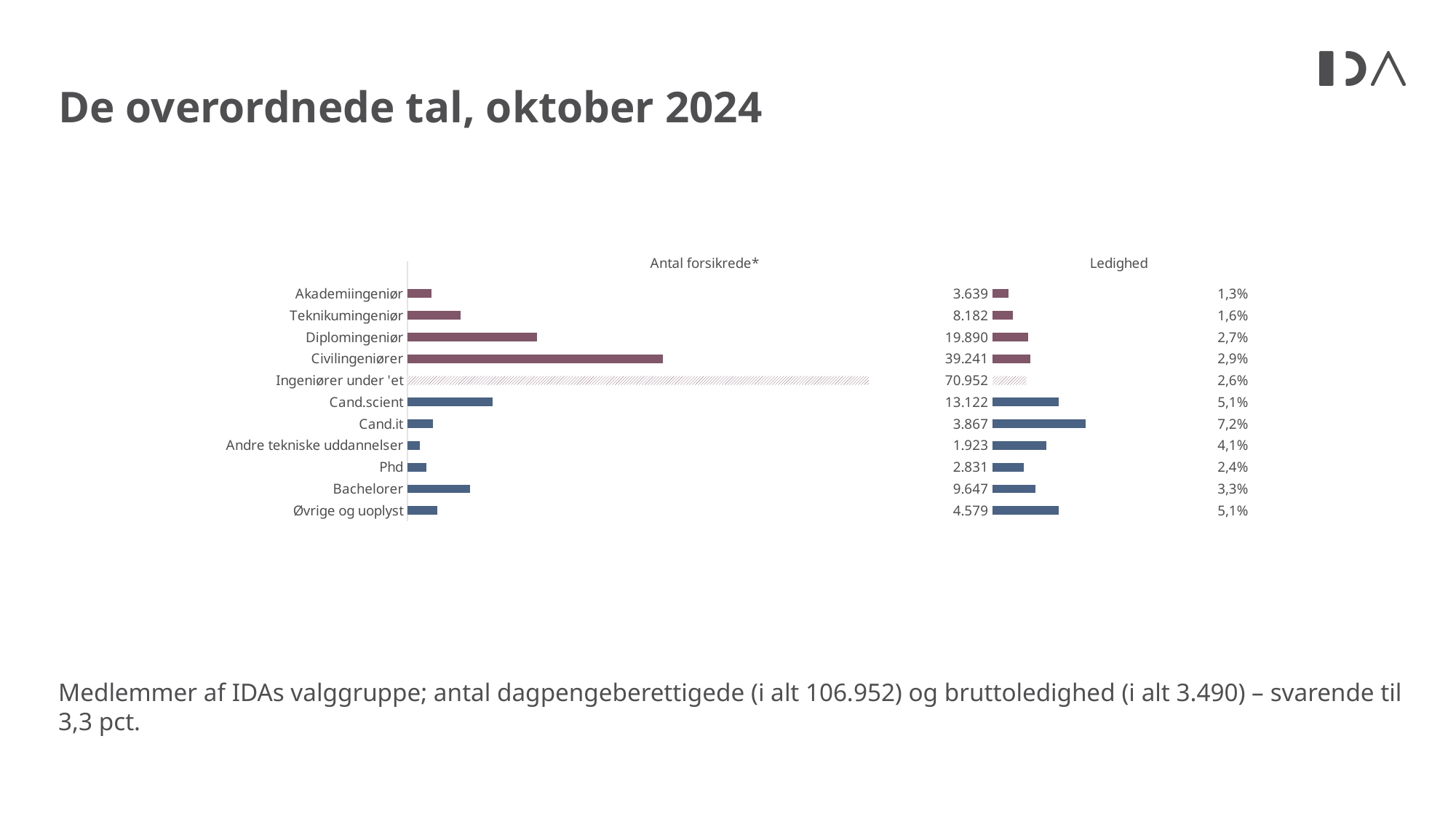
In the Ledighed chart, which category has the lowest value? Akademiingeniør In the Ledighed chart, what is the value for Cand.it? 7,2% In the Ledighed chart, what is the value for Phd? 2,4% In the Ledighed chart, which is larger, Teknikumingeniør or Andre tekniske uddannelser? Andre tekniske uddannelser In the Antal forsikrede* chart, what is the value for Bachelorer? 9.647 In the Antal forsikrede* chart, what is the difference between Civilingeniører and Diplomingeniør? 19.351 How many categories are shown in the Antal forsikrede* chart? 11 What kind of chart is the Ledighed chart? Bar chart In the Antal forsikrede* chart, which is larger, Cand.scient or Bachelorer? Cand.scient In the Ledighed chart, which category has the highest value? Cand.it In the Antal forsikrede* chart, what is the value for Civilingeniører? 39.241 In the Antal forsikrede* chart, which category has the lowest value? Andre tekniske uddannelser